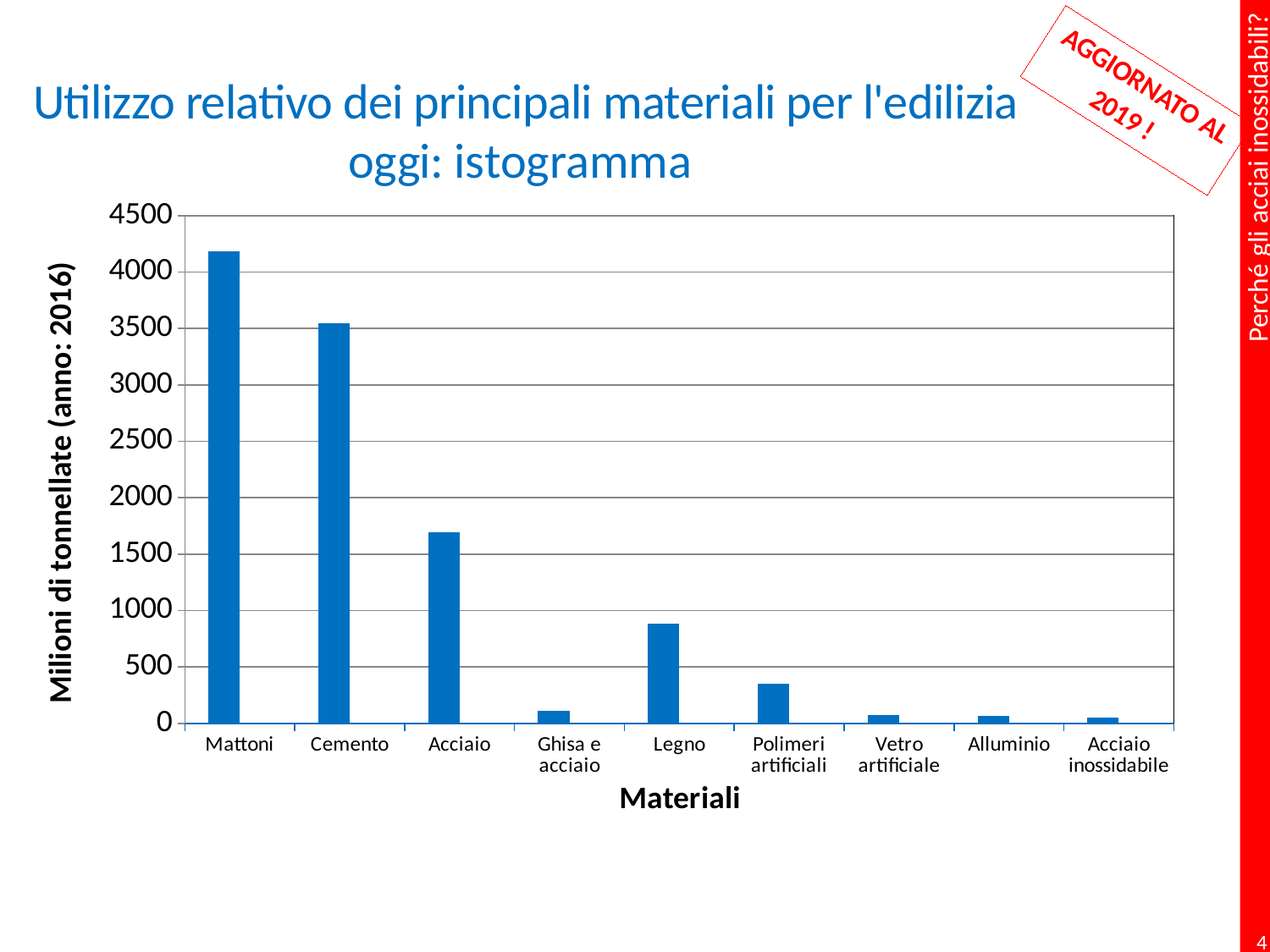
How many materials are shown on the x axis of the chart? 9 Which has a larger value, Cemento or Acciaio? Cemento Which has a larger value, Legno or Ghisa e acciaio? Legno Is the value for Cemento greater or less than 3000? greater What is the title of the y axis of the chart? Milioni di tonnellate (anno: 2016) What is the title of the x axis of the chart? Materiali Is the value for Acciaio greater or less than 1500? greater Is the value for Polimeri artificiali greater or less than 500? less What kind of chart is shown on the slide? bar chart Which material has the highest value in the chart? Mattoni